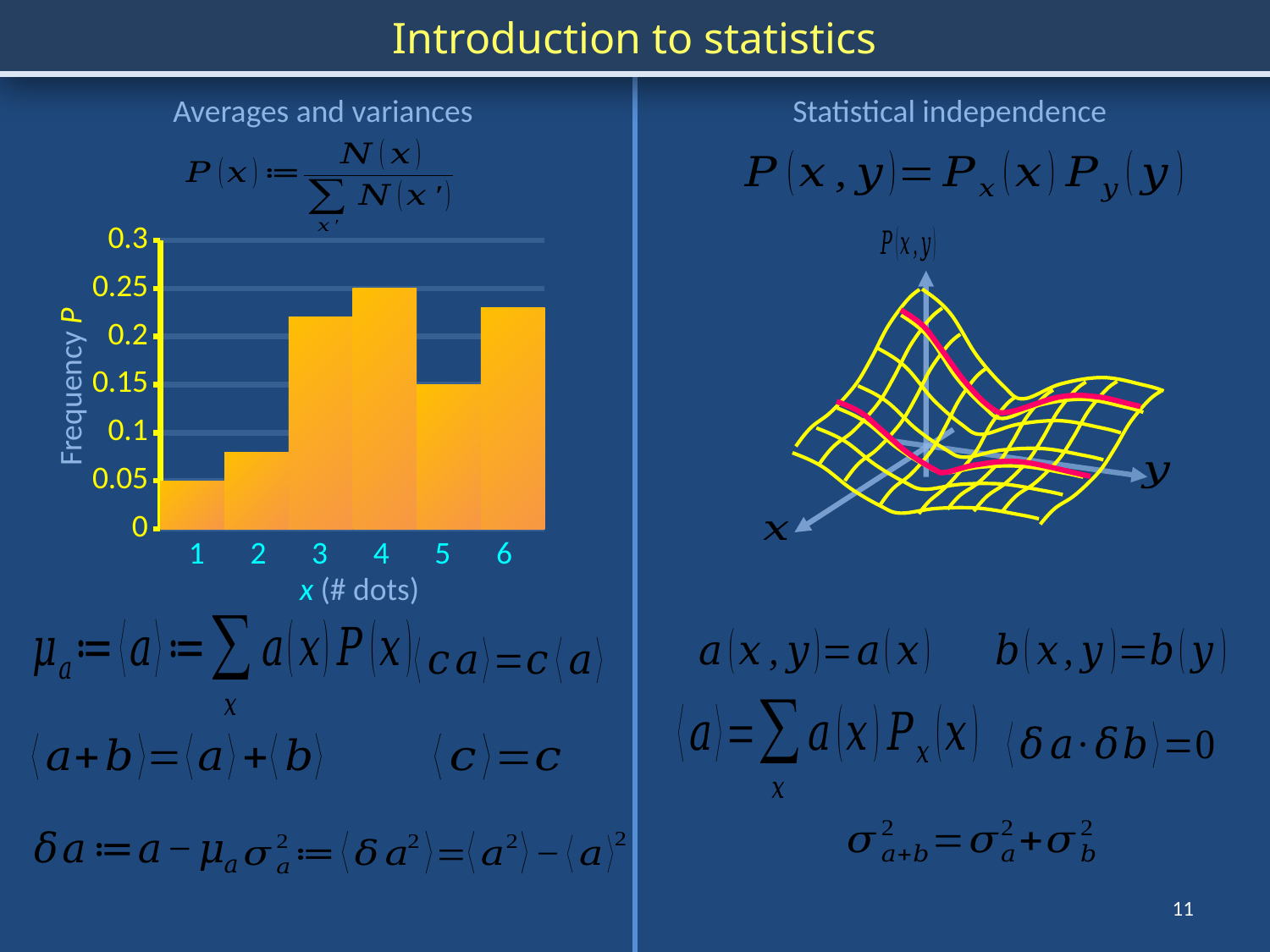
In the bar chart on the left, which has the larger frequency P: x = 4 or x = 5? 4 In the bar chart on the left, is the frequency P for x = 6 greater or less than 0.2? greater In the bar chart on the left, which has the larger frequency P: x = 1 or x = 2? 2 In the bar chart on the left, what is the frequency P for x = 4? 0.25 In the bar chart on the left, how many x (# dots) categories are plotted? 6 What kind of chart is shown on the left side of the slide under 'Averages and variances'? bar chart In the bar chart on the left, what is the frequency P for x = 5? 0.15 In the bar chart on the left, which x value has the highest frequency P? 4 In the bar chart on the left, is the frequency P for x = 2 greater or less than 0.1? less What is the label of the horizontal axis of the bar chart on the left? x (# dots) In the bar chart on the left, which x value has the lowest frequency P? 1 In the bar chart on the left, is the frequency P for x = 3 greater or less than 0.2? greater